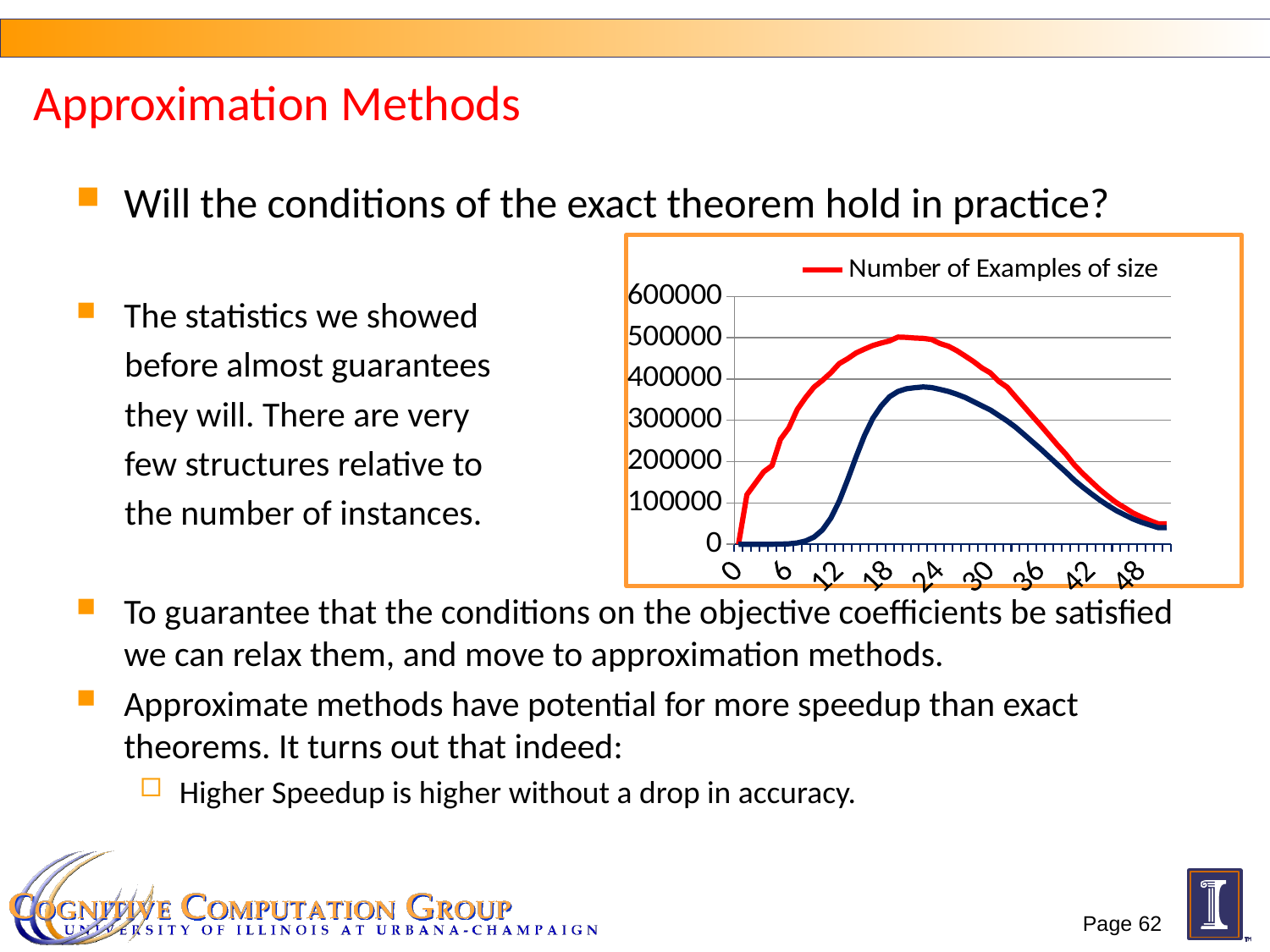
Is the value of the dark blue line at x = 6 greater or less than 100000? less What series name does the chart's legend show? Number of Examples of size Is the peak value of the dark blue line greater or less than 400000? less Is the value of the red line (Number of Examples of size) at x = 42 greater or less than 100000? greater At x = 24, which line has the larger value, the red line or the dark blue line? the red line What is the highest value labelled on the chart's vertical axis? 600000 Which line reaches the higher peak, the red line or the dark blue line? the red line Does the red line (Number of Examples of size) rise or fall between x = 24 and x = 48? fall What kind of chart is shown on the slide? line chart